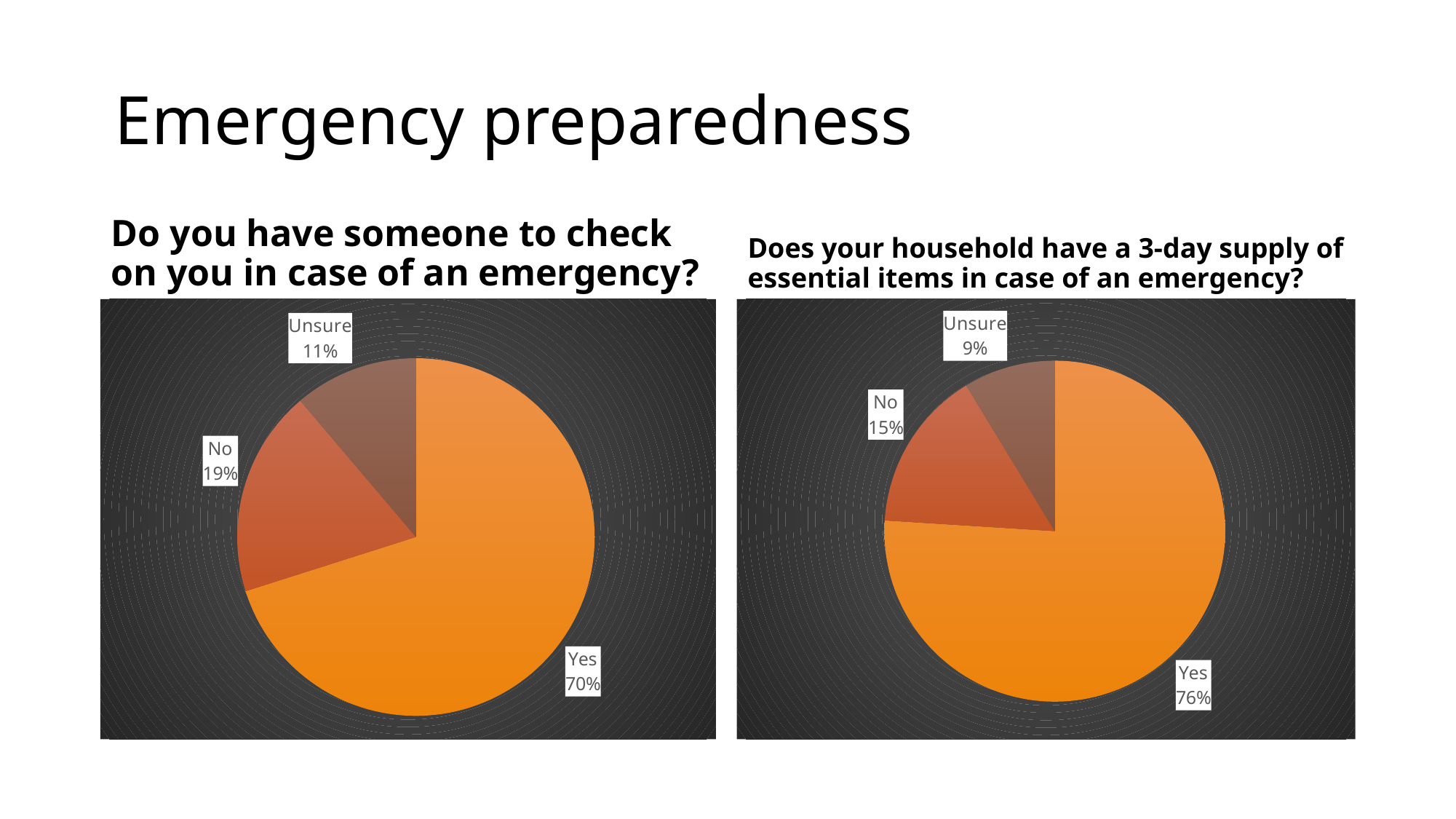
In the right chart ('Does your household have a 3-day supply of essential items in case of an emergency?'), what share of respondents answered No? 15% In the left chart ('Do you have someone to check on you in case of an emergency?'), what is the difference in percentage points between the No and Unsure slices? 8 In the left chart ('Do you have someone to check on you in case of an emergency?'), what share of respondents answered No? 19% In the right chart ('Does your household have a 3-day supply of essential items in case of an emergency?'), which response has the smallest slice? Unsure How many slices does the right chart ('Does your household have a 3-day supply of essential items in case of an emergency?') have? 3 In the left chart ('Do you have someone to check on you in case of an emergency?'), which response has the largest slice? Yes In the left chart ('Do you have someone to check on you in case of an emergency?'), what share of respondents answered Yes? 70% Which chart has the larger Yes share, the left chart or the right chart? The right chart In the right chart ('Does your household have a 3-day supply of essential items in case of an emergency?'), what share of respondents answered Unsure? 9% In the left chart ('Do you have someone to check on you in case of an emergency?'), what share of respondents answered Unsure? 11% In the right chart ('Does your household have a 3-day supply of essential items in case of an emergency?'), what share of respondents answered Yes? 76% What type of chart is the left chart ('Do you have someone to check on you in case of an emergency?')? Pie chart